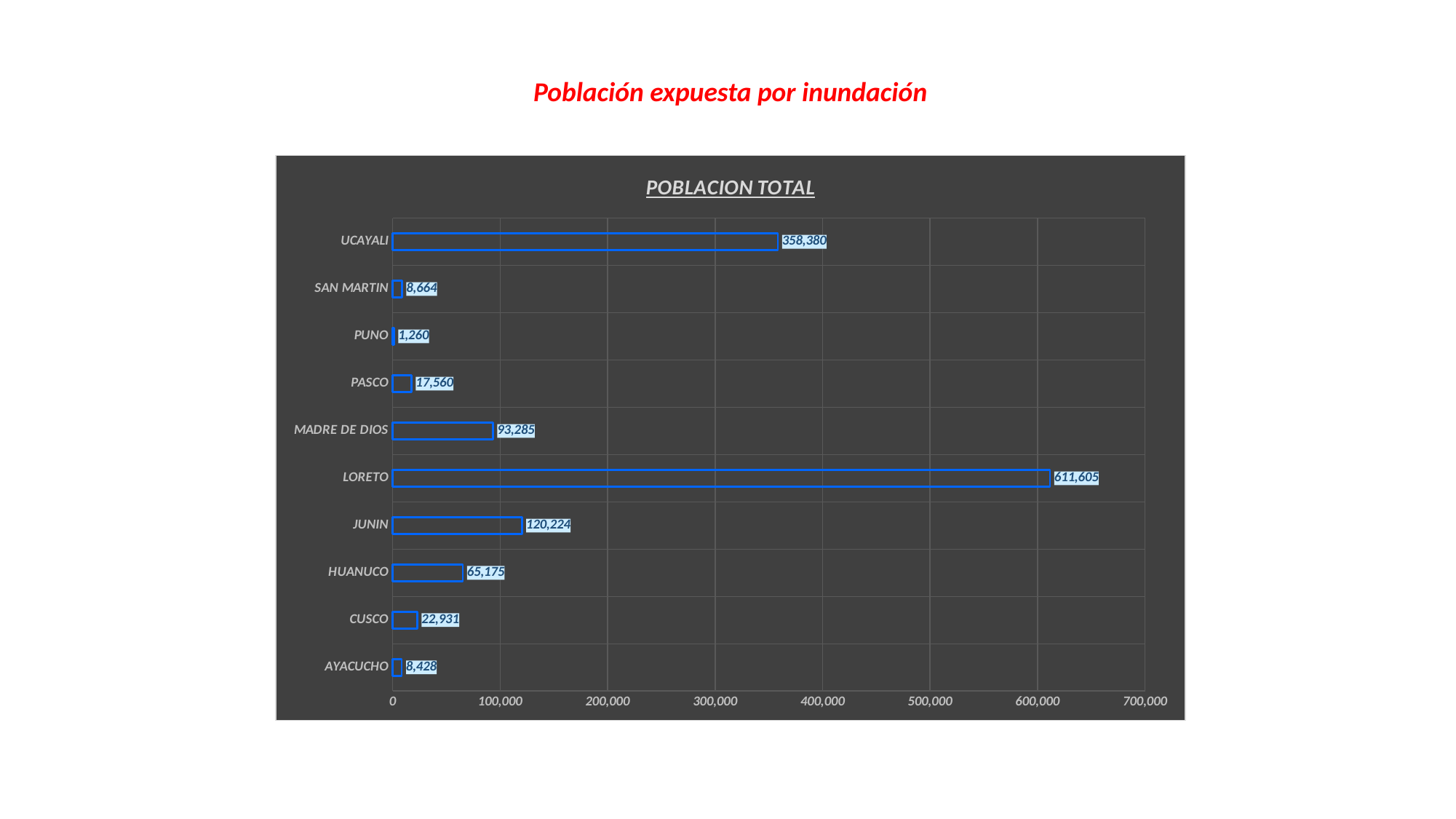
What is the value for PUNO? 1,260 Which category has the highest value? LORETO Which is larger, the value for JUNIN or the value for HUANUCO? JUNIN What is the value for MADRE DE DIOS? 93,285 What is the difference between the values for CUSCO and AYACUCHO? 14,503 What is the value for LORETO? 611,605 Is the value for UCAYALI greater or less than 300,000? greater Which category has the lowest value? PUNO What kind of chart is shown? bar chart How many categories are shown in the chart? 10 What is the title of the chart? POBLACION TOTAL What is the difference between the values for LORETO and UCAYALI? 253,225